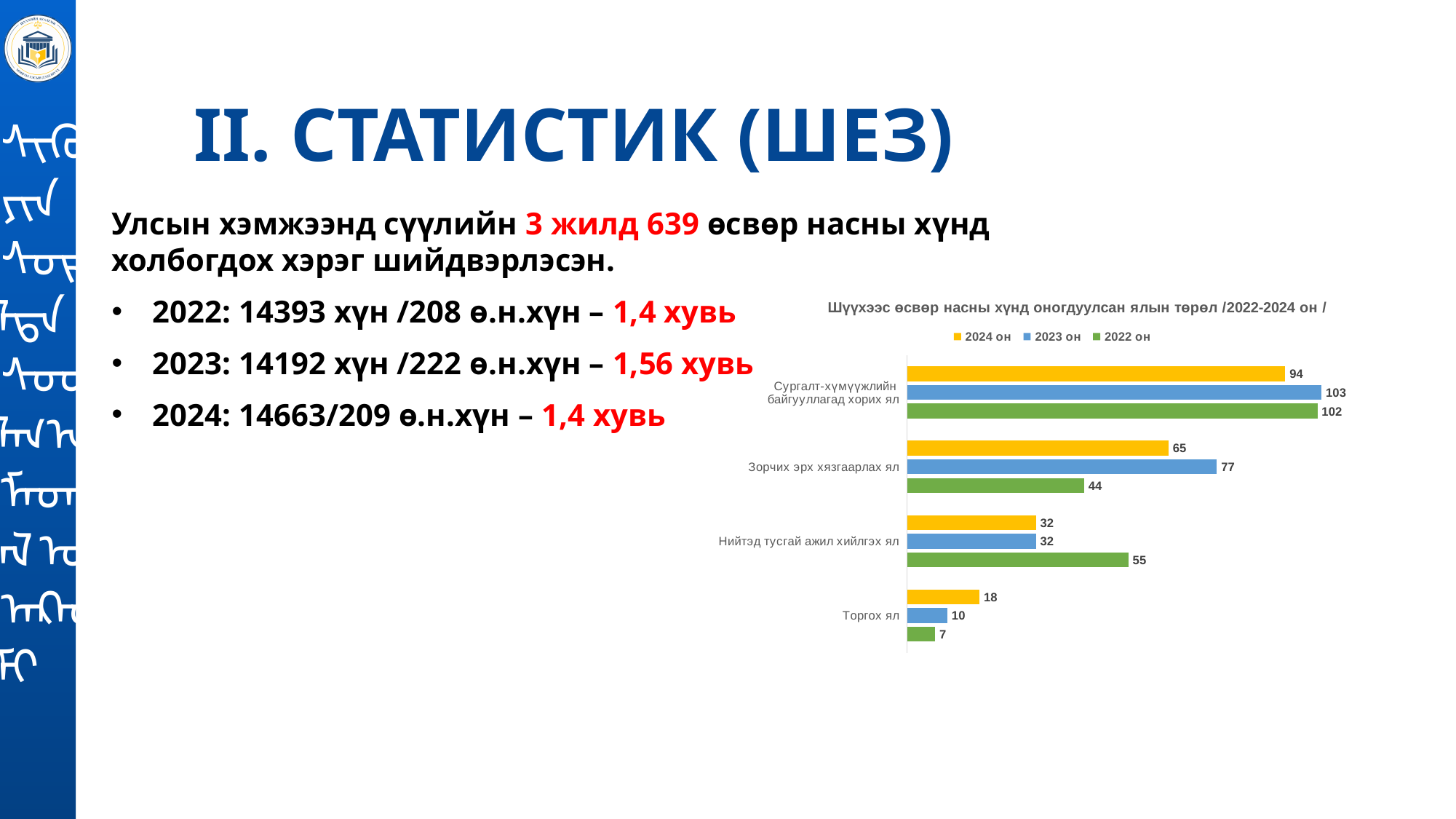
Which is larger for Нийтэд тусгай ажил хийлгэх ял: the 2022 он value or the 2024 он value? 2022 он How many categories are shown on the chart? 4 What kind of chart is shown on the slide? Bar chart What is the value for 2024 он in the Торгох ял category? 18 How many series does the legend list? 3 Which category has the highest value for 2024 он? Сургалт-хүмүүжлийн байгууллагад хорих ял Which category has the lowest value for 2022 он? Торгох ял What is the difference between the 2023 он and 2024 он values for Зорчих эрх хязгаарлах ял? 12 What is the value for 2022 он in the Зорчих эрх хязгаарлах ял category? 44 What is the value for 2023 он in the Сургалт-хүмүүжлийн байгууллагад хорих ял category? 103 What is the total of the three series values for Торгох ял? 35 Which colour represents the 2022 он series in the chart? Green